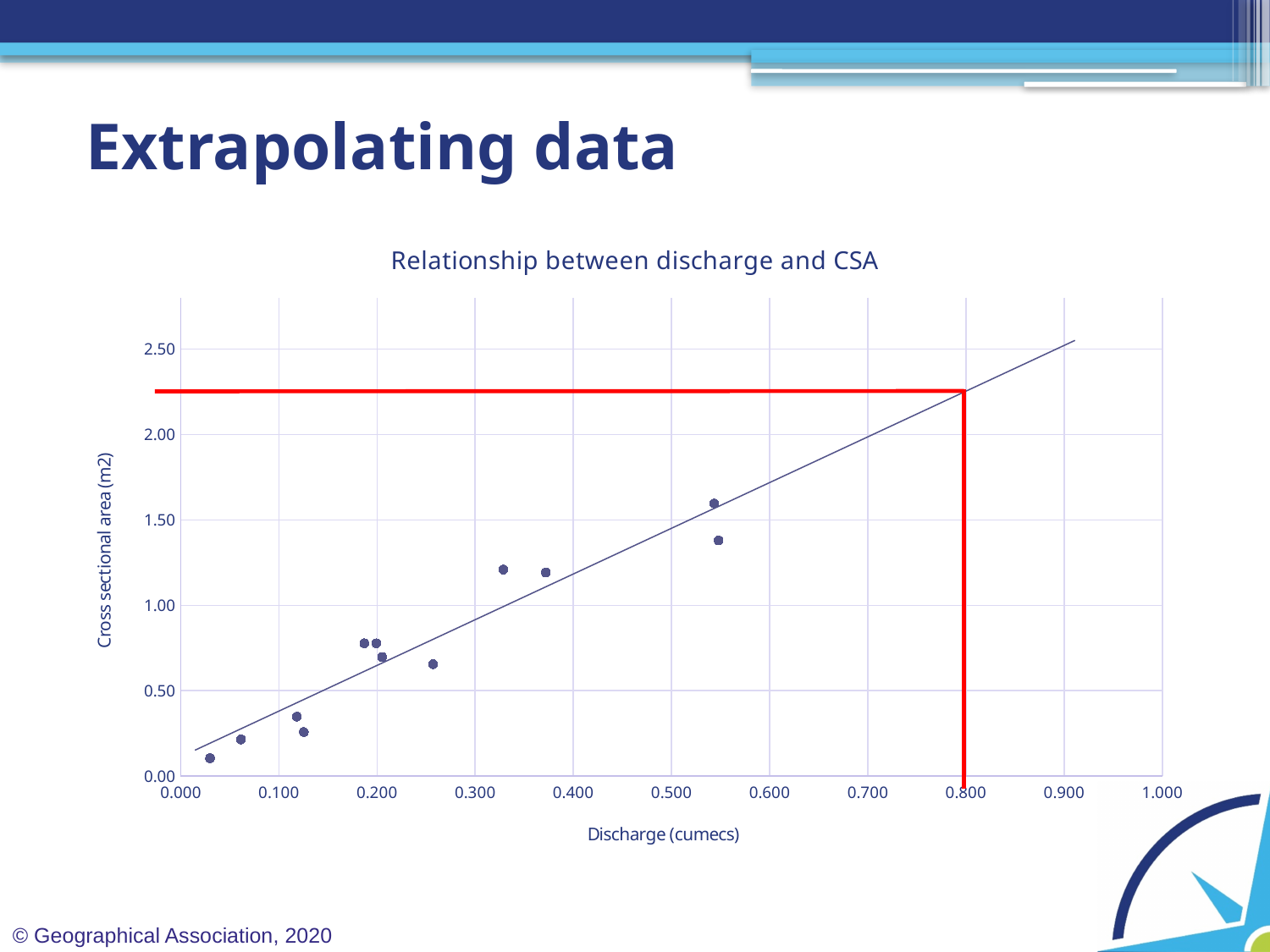
What is the label of the x axis? Discharge (cumecs) Do the cross sectional area values generally rise or fall as discharge increases along the x axis? rise What is the title of the chart? Relationship between discharge and CSA Is the cross sectional area of the lowest plotted point greater or less than 0.50? less What is the highest value shown on the x axis? 1.000 Is the cross sectional area of the point at a discharge of about 0.260 greater or less than 1.00? less What kind of chart is shown on the slide? scatter chart Which has the larger cross sectional area: the point at a discharge of about 0.545 or the point at about 0.550? the point at about 0.545 Is the cross sectional area of the highest plotted point greater or less than 1.50? greater How many data points are plotted on the chart? 12 At which discharge value on the x axis does the vertical red line meet the axis? 0.800